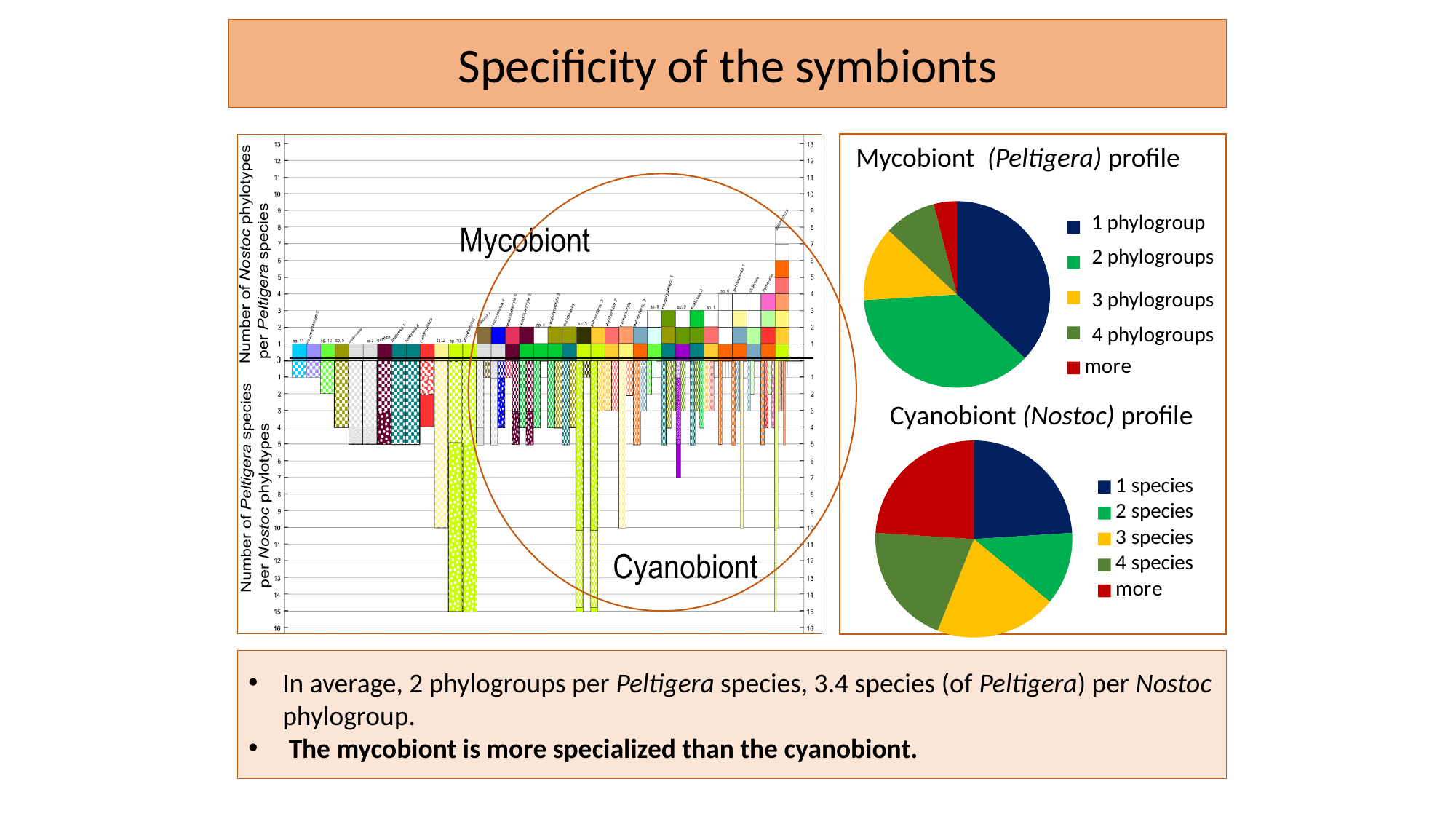
What kind of chart is the 'Cyanobiont (Nostoc) profile' chart? pie chart In the 'Cyanobiont (Nostoc) profile' pie chart, which category has the smallest slice? 2 species What kind of chart is the 'Mycobiont (Peltigera) profile' chart? pie chart In the 'Mycobiont (Peltigera) profile' pie chart, which slice is larger: '3 phylogroups' or '4 phylogroups'? 3 phylogroups How many categories does the legend of the 'Cyanobiont (Nostoc) profile' pie chart list? 5 What kind of chart is the large chart on the left of the slide labelled 'Mycobiont' and 'Cyanobiont'? bar chart In the 'Cyanobiont (Nostoc) profile' pie chart, which slice is larger: '1 species' or '2 species'? 1 species In the 'Cyanobiont (Nostoc) profile' pie chart, which slice is larger: '2 species' or '3 species'? 3 species In the 'Cyanobiont (Nostoc) profile' pie chart, what colour is the '1 species' slice? navy blue How many categories does the legend of the 'Mycobiont (Peltigera) profile' pie chart list? 5 In the 'Mycobiont (Peltigera) profile' pie chart, what colour is the 'more' slice? red In the 'Mycobiont (Peltigera) profile' pie chart, which category has the smallest slice? more